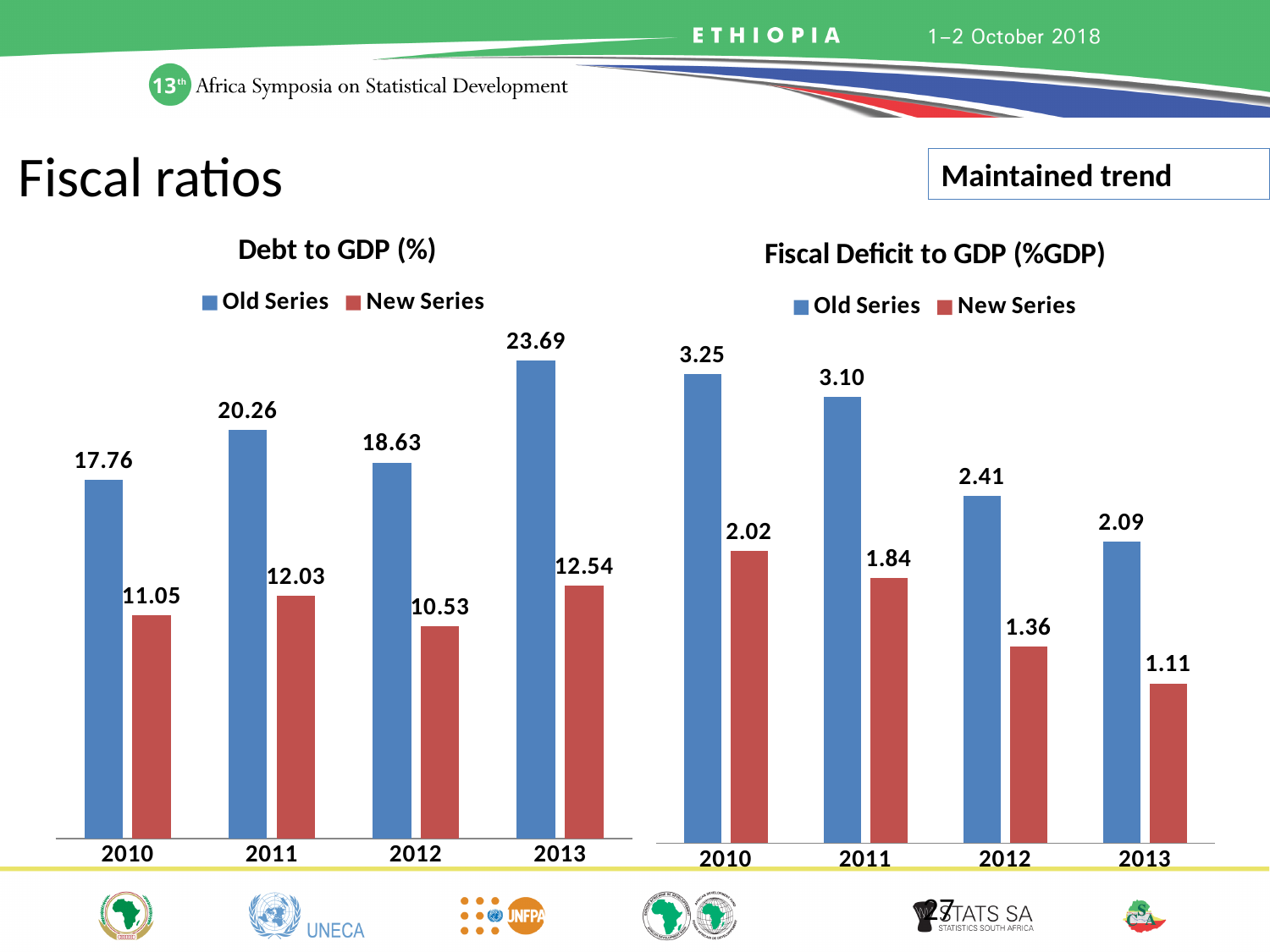
What kind of chart is the 'Debt to GDP (%)' chart? Bar chart In the 'Debt to GDP (%)' chart, what is the New Series value for 2012? 10.53 In the 'Debt to GDP (%)' chart, which year has the highest Old Series value? 2013 In the 'Fiscal Deficit to GDP (%GDP)' chart, which year has the lowest New Series value? 2013 How many series does the legend of the 'Fiscal Deficit to GDP (%GDP)' chart list? 2 In the 'Debt to GDP (%)' chart, what is the difference between the Old Series and New Series values for 2011? 8.23 In the 'Debt to GDP (%)' chart, which is larger: the New Series value for 2011 or the New Series value for 2013? 2013 In the 'Fiscal Deficit to GDP (%GDP)' chart, what is the New Series value for 2013? 1.11 In the 'Fiscal Deficit to GDP (%GDP)' chart, do the Old Series values rise or fall from 2010 to 2013? Fall In the 'Debt to GDP (%)' chart, what is the Old Series value for 2013? 23.69 In the 'Fiscal Deficit to GDP (%GDP)' chart, what is the Old Series value for 2010? 3.25 In the 'Fiscal Deficit to GDP (%GDP)' chart, what is the difference between the Old Series values for 2010 and 2013? 1.16